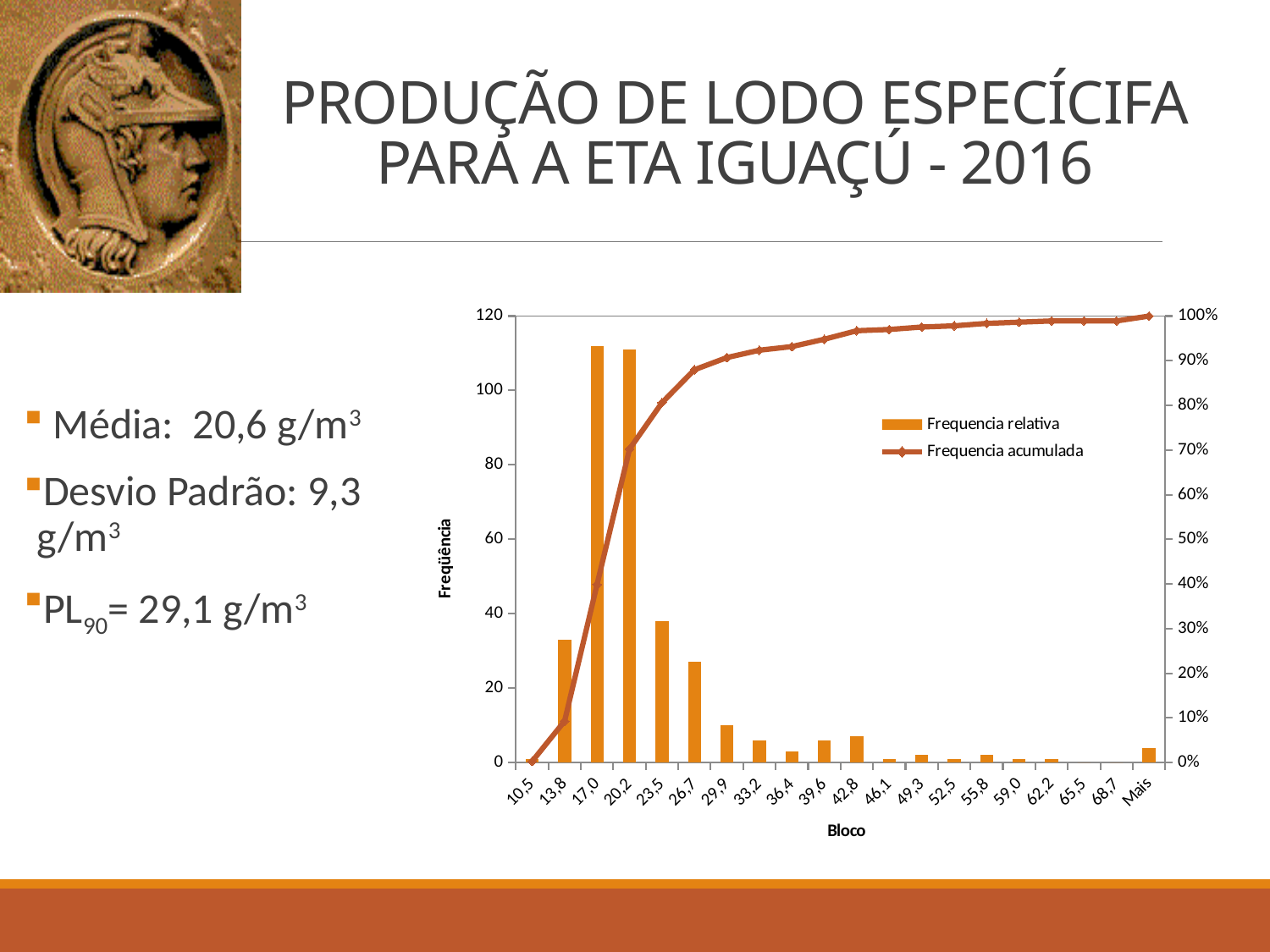
How many categories are shown on the x axis of the chart? 20 Is the Frequencia relativa bar for 29,9 greater or less than 20? less What kind of chart is shown on the slide? A combined bar and line chart Is the Frequencia relativa bar for 13,8 greater or less than 20? greater Is the Frequencia acumulada value at 26,7 greater or less than 80%? greater What is the title of the x axis of the chart? Bloco What are the two series named in the chart legend? Frequencia relativa and Frequencia acumulada Does the Frequencia acumulada line rise or fall along the x axis? rises How many series does the chart legend list? 2 Which has the larger Frequencia relativa bar, 13,8 or 26,7? 13,8